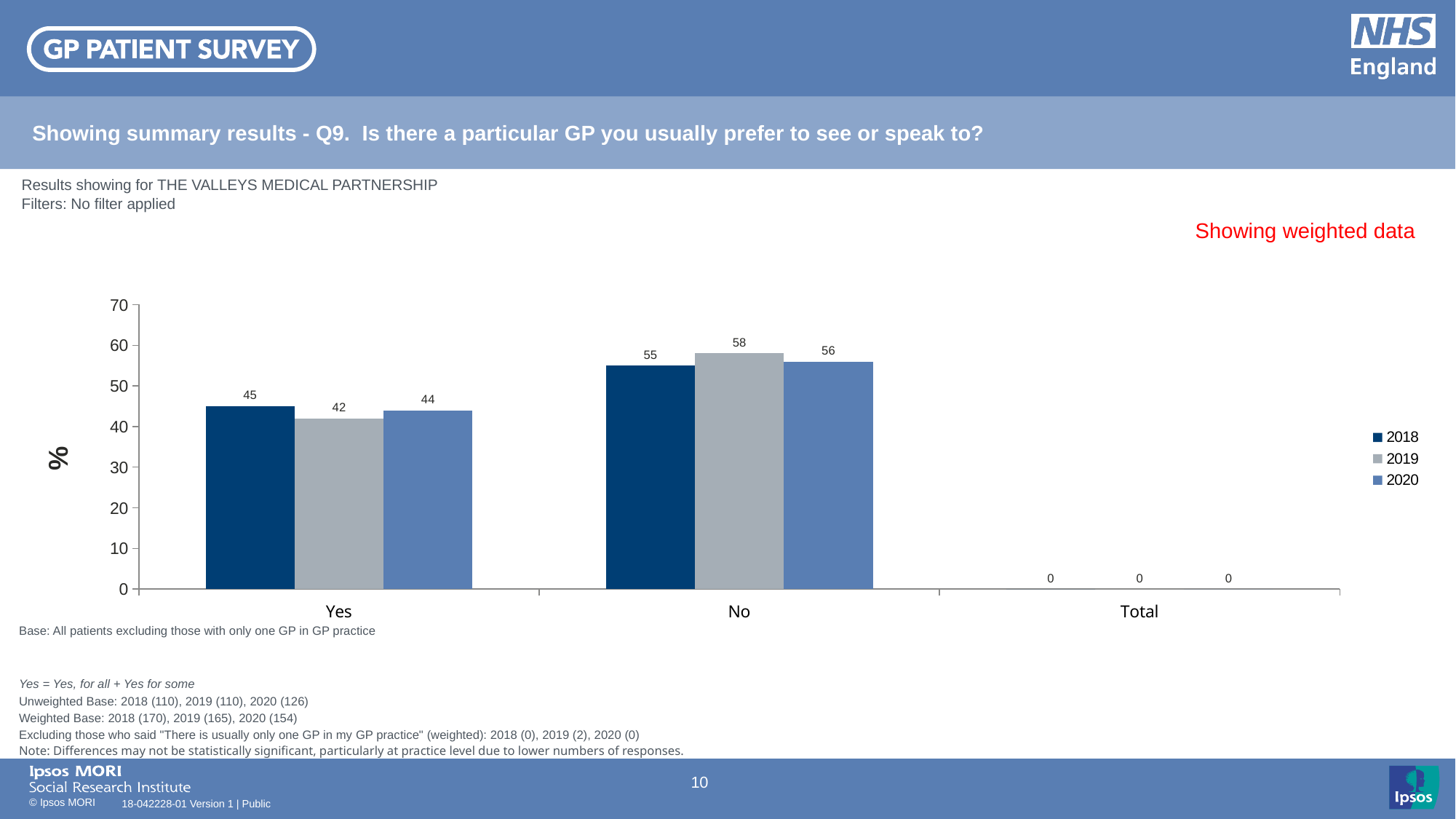
How many series does the legend list? 3 What kind of chart is shown on the slide? Bar chart What is the value for 'Yes' in 2020? 44 What is the value for 'Yes' in 2018? 45 Which year has the highest value for 'No'? 2019 What is the value for 'No' in 2019? 58 Is the 2020 value for 'No' larger than the 2020 value for 'Yes'? Yes Is the value for 'No' in 2019 greater or less than 50? greater What is the value for 'Total' in 2020? 0 What is the difference between the 'No' and 'Yes' values in 2018? 10 Which year has the lowest value for 'Yes'? 2019 How many categories are shown on the x axis? 3